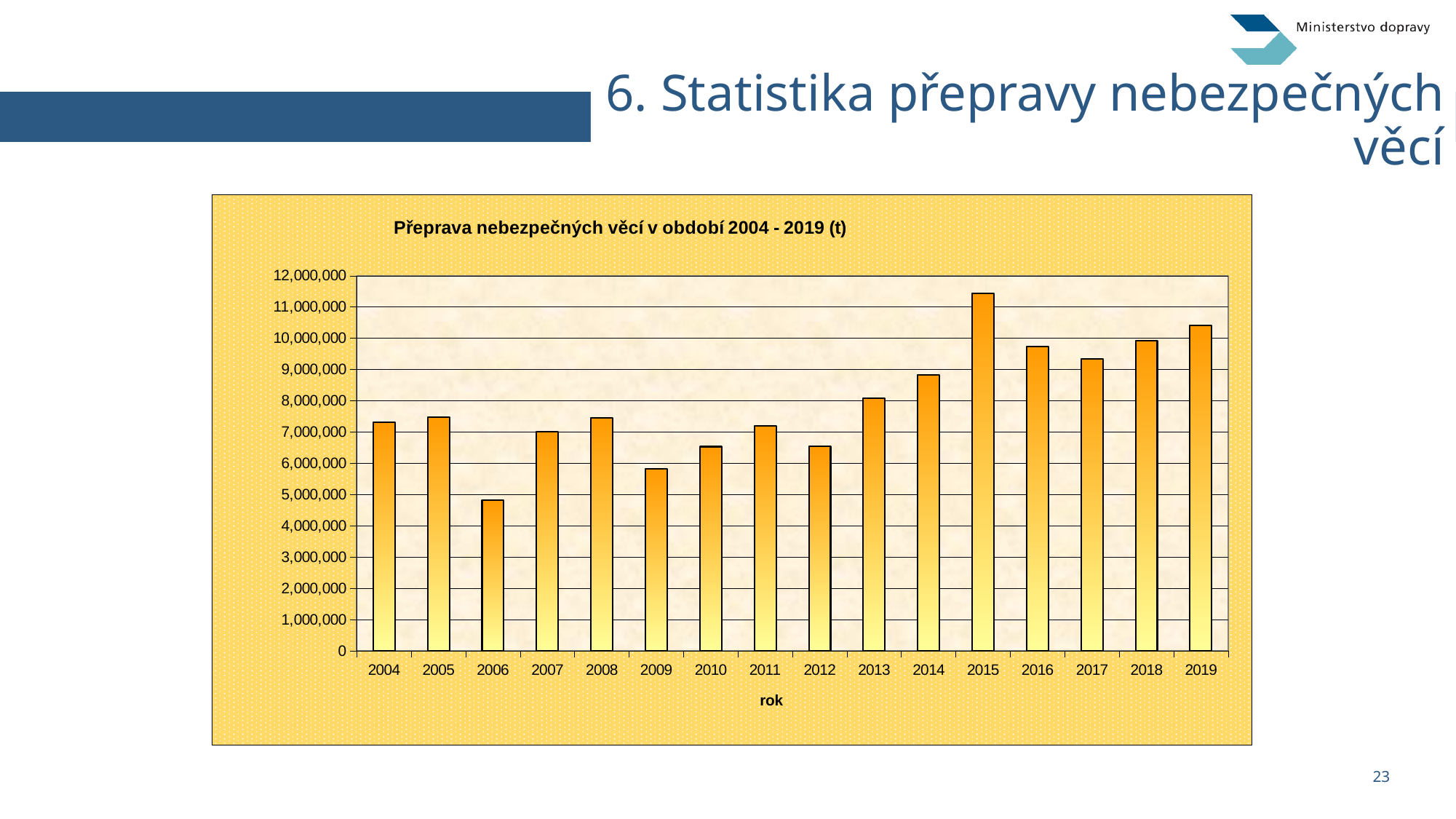
What is the label of the x axis? rok Do the values rise or fall from 2012 to 2015? rise Is the value for 2015 greater or less than 11,000,000? greater Is the value for 2009 greater or less than 6,000,000? less What kind of chart is shown on the slide? bar chart Which year has the highest value? 2015 What is the title of the chart? Přeprava nebezpečných věcí v období 2004 - 2019 (t) How many years are plotted in the chart? 16 Which year has the larger value, 2006 or 2009? 2009 Which year has the lowest value? 2006 Is the value for 2006 greater or less than 5,000,000? less